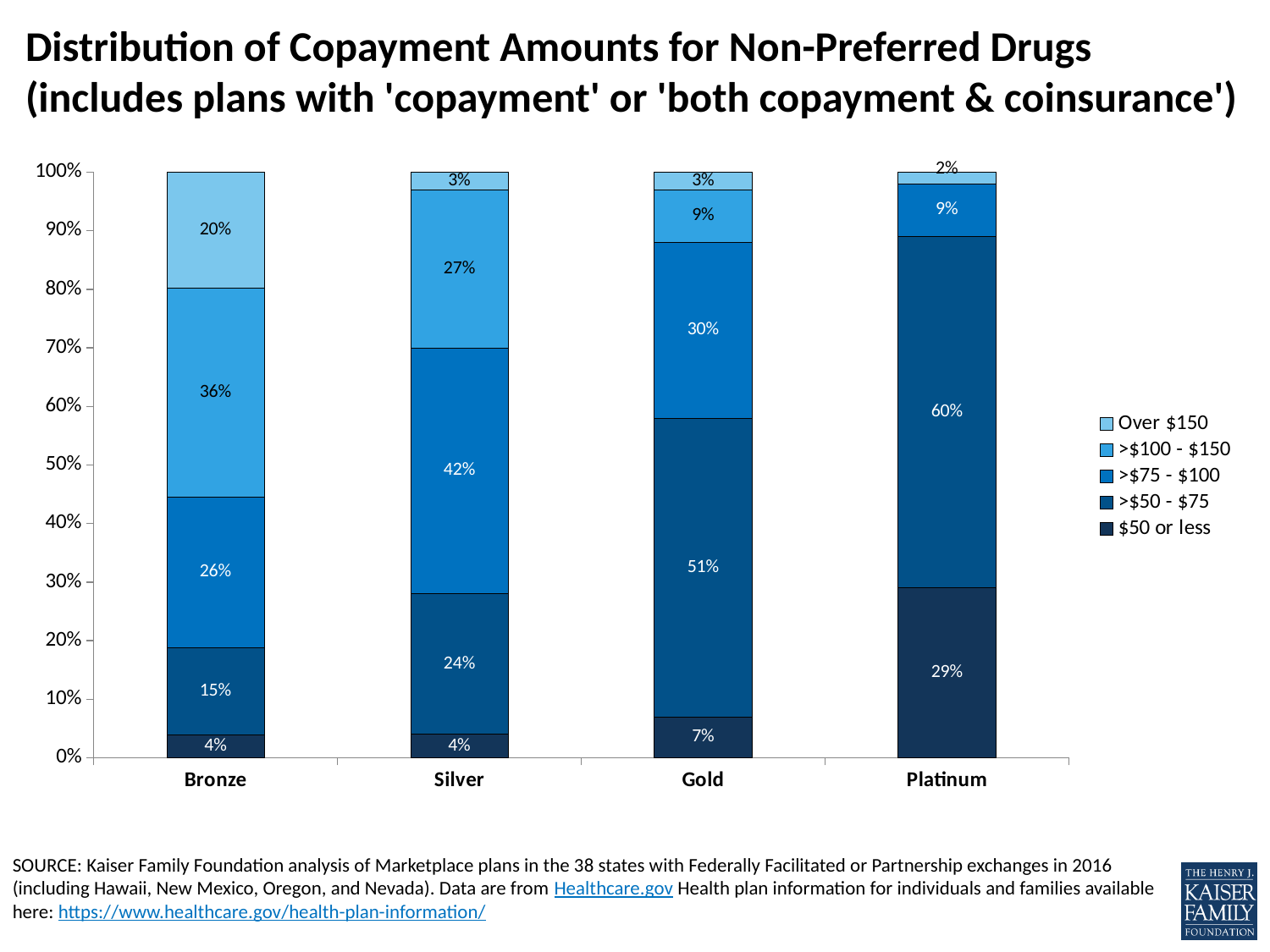
What percentage of Bronze plans have a copayment of over $150 for non-preferred drugs? 20% What is the value of the >$75 - $100 segment for Silver? 42% How many percentage points larger is the >$50 - $75 segment for Gold than for Silver? 27 percentage points How many copayment ranges does the legend list? 5 Which has a larger >$100 - $150 segment, Bronze or Silver? Bronze What share of Gold plans have a copayment of $50 or less? 7% What kind of chart is shown on the slide? Stacked bar chart Which metal level has the highest share of plans with a copayment of $50 or less? Platinum Does the share of plans with a copayment of $50 or less rise or fall from Bronze to Platinum? Rises What is the value of the >$50 - $75 segment for Platinum? 60% How many metal levels are shown on the x axis? 4 Which metal level has the lowest share of plans in the >$50 - $75 category? Bronze